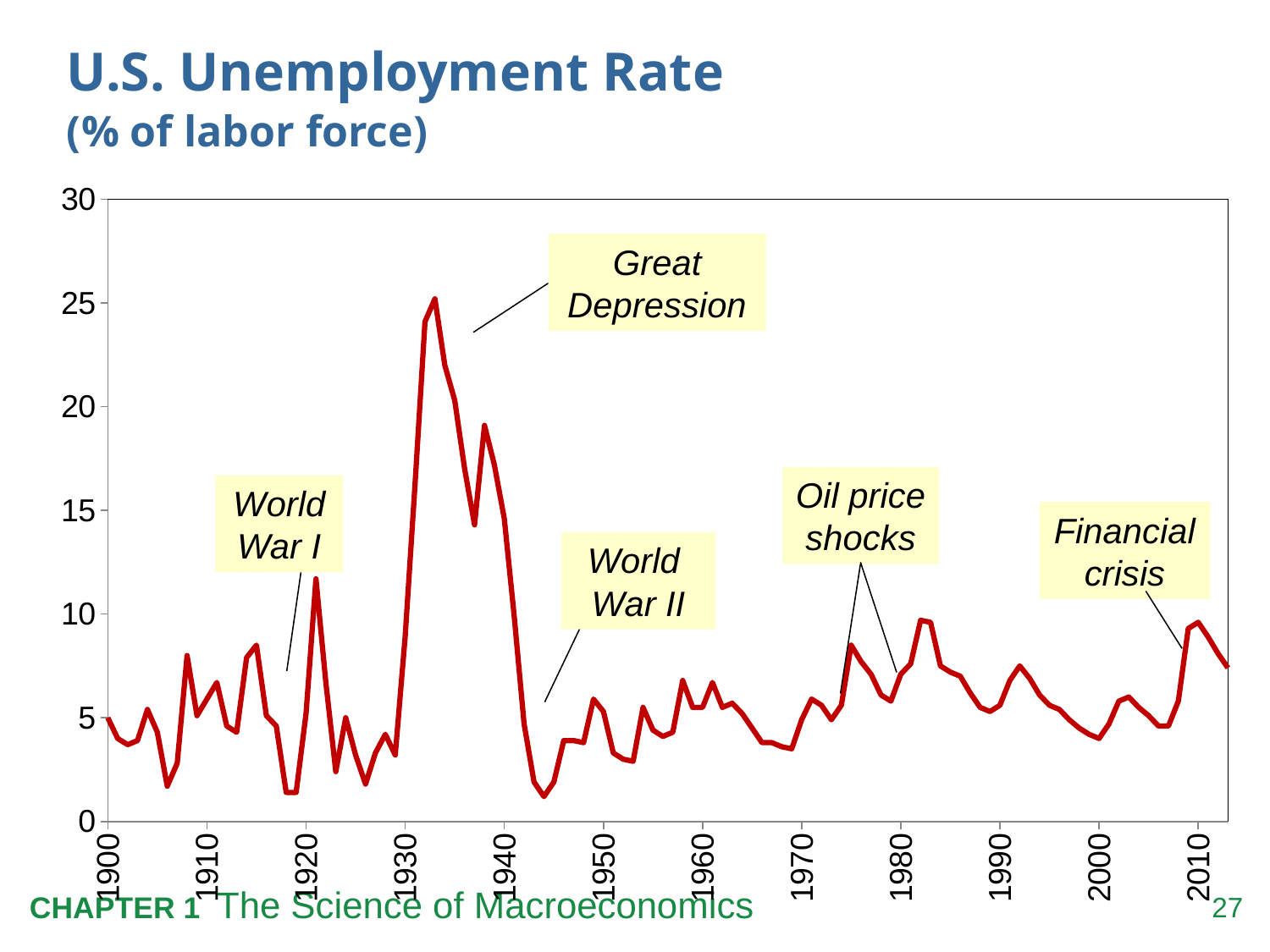
What is the title of the chart? U.S. Unemployment Rate (% of labor force) What is the maximum value shown on the vertical axis? 30 How many annotated events are labeled on the chart? 5 Is the unemployment rate at the peak labeled Financial crisis greater or less than 15? less Is the peak unemployment rate during the Great Depression greater or less than 20? greater Does the unemployment rate rise or fall between 1940 and 1944? fall What kind of chart is shown on the slide? line chart Is the unemployment rate at its lowest point during World War II greater or less than 5? less Which is higher, the unemployment rate peak during the Great Depression or the peak during the Financial crisis? Great Depression Which annotated event on the chart corresponds to the highest unemployment rate? Great Depression Does the unemployment rate rise or fall between 1930 and 1933? rise